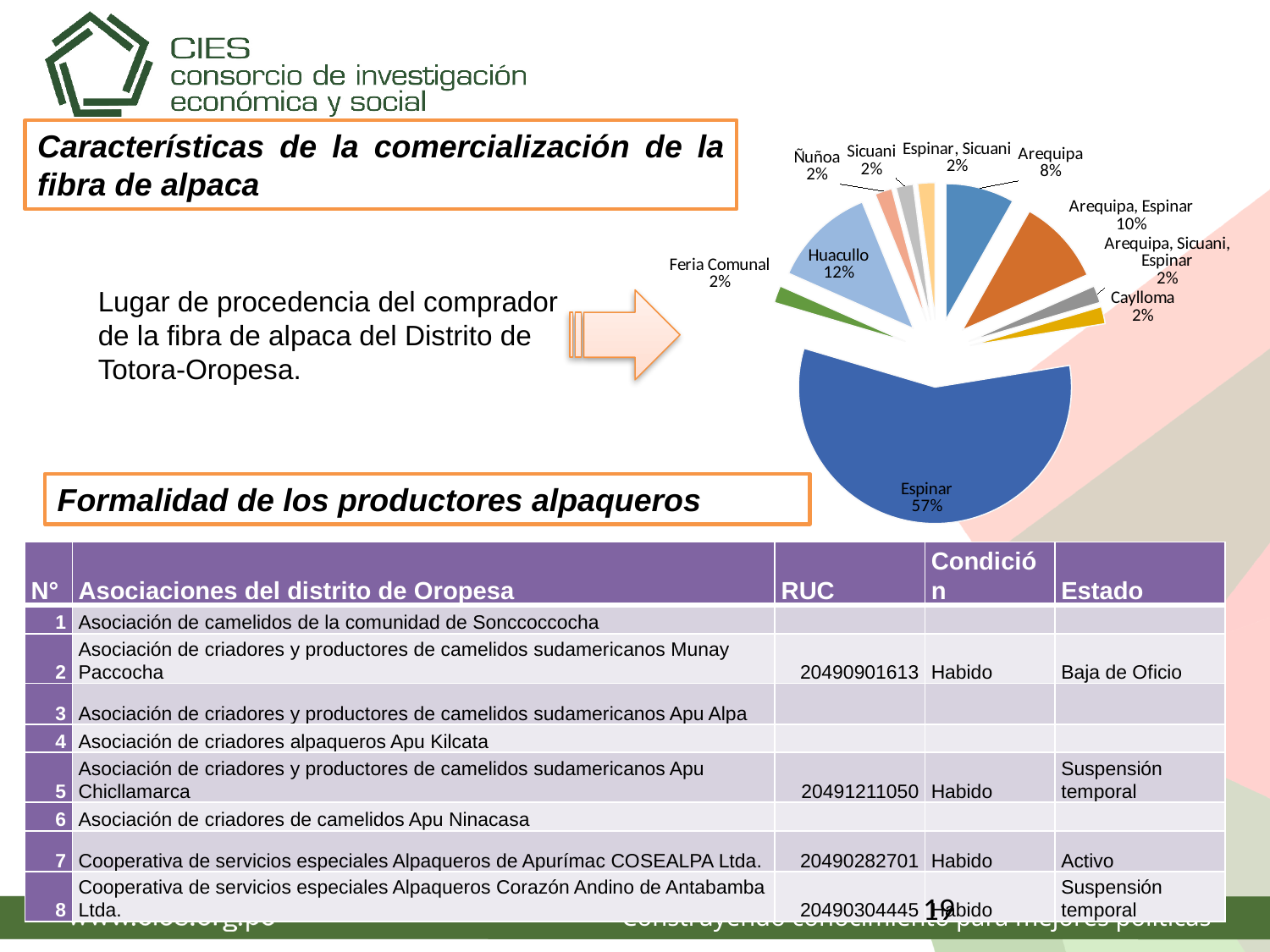
What is the value shown for Huacullo in the pie chart? 12% What is the value shown for Caylloma in the pie chart? 2% How many slices does the pie chart have? 10 What is the value shown for Arequipa in the pie chart? 8% Which category has the largest slice in the pie chart? Espinar What is the difference between the Arequipa, Espinar slice and the Arequipa slice? 2% What is the value shown for Arequipa, Espinar in the pie chart? 10% What is the value shown for Feria Comunal in the pie chart? 2% Which is larger in the pie chart, Huacullo or Arequipa? Huacullo What type of chart is shown on the slide? pie chart What share of the pie chart does Espinar represent? 57% What is the difference between the Espinar slice and the Huacullo slice? 45%